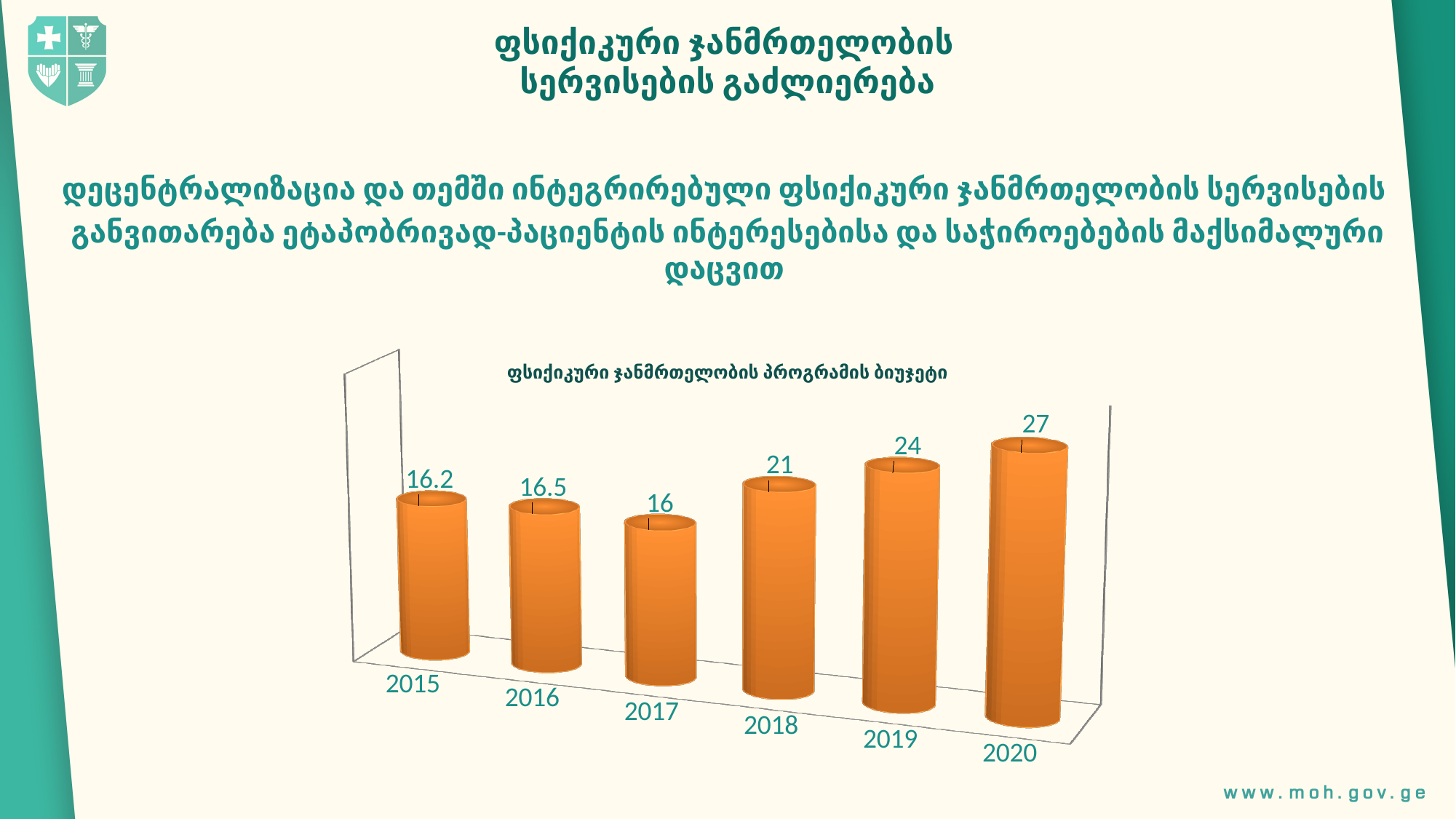
Do the values rise or fall from 2017 to 2020? Rise What kind of chart is shown on the slide? Bar chart What is the value for 2018? 21 How many years are shown on the chart? 6 What is the difference between the values for 2019 and 2018? 3 What is the value for 2020? 27 Which year has the highest value? 2020 Which is larger, the value for 2016 or the value for 2017? 2016 What is the value for 2015? 16.2 What is the difference between the values for 2020 and 2015? 10.8 What is the title of the chart? ფსიქიკური ჯანმრთელობის პროგრამის ბიუჯეტი Which year has the lowest value? 2017